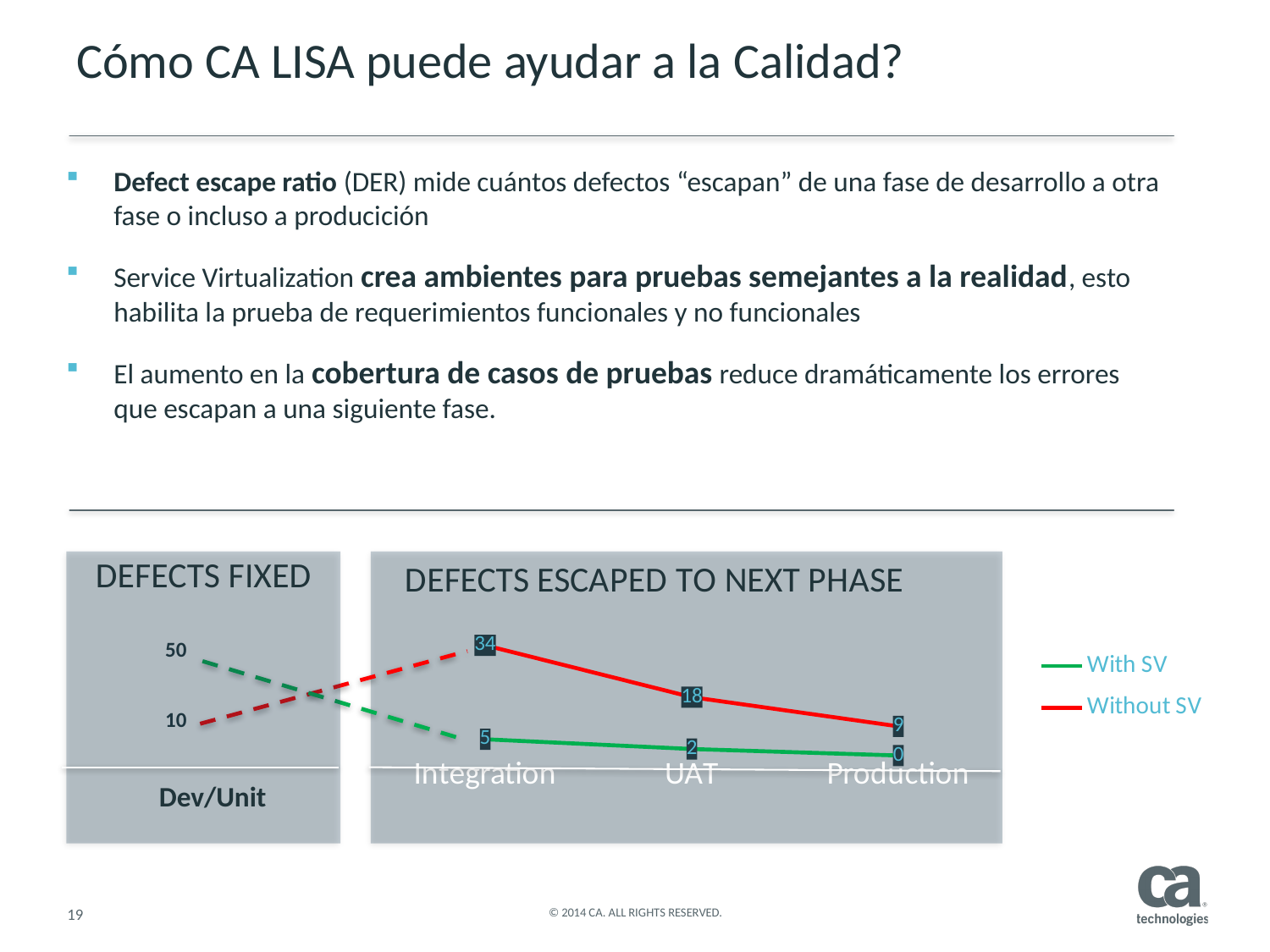
How many series does the legend of the 'DEFECTS ESCAPED TO NEXT PHASE' chart list? 2 How many phases are shown on the x axis of the 'DEFECTS ESCAPED TO NEXT PHASE' chart? 3 In the 'DEFECTS ESCAPED TO NEXT PHASE' chart, what is the value for Without SV at Integration? 34 What kind of chart is 'DEFECTS ESCAPED TO NEXT PHASE'? Line chart In the 'DEFECTS ESCAPED TO NEXT PHASE' chart, what is the value for With SV at UAT? 2 In the 'DEFECTS ESCAPED TO NEXT PHASE' chart, what is the difference between the Without SV and With SV values at UAT? 16 In the 'DEFECTS ESCAPED TO NEXT PHASE' chart, what is the value for With SV at Production? 0 In the 'DEFECTS ESCAPED TO NEXT PHASE' chart, at which phase is the Without SV value highest? Integration In the 'DEFECTS ESCAPED TO NEXT PHASE' chart, at which phase is the With SV value lowest? Production In the 'DEFECTS ESCAPED TO NEXT PHASE' chart, which series has the larger value at Integration, With SV or Without SV? Without SV In the 'DEFECTS ESCAPED TO NEXT PHASE' chart, what is the value for Without SV at Production? 9 In the 'DEFECTS ESCAPED TO NEXT PHASE' chart, what is the difference between the Without SV values at Integration and UAT? 16